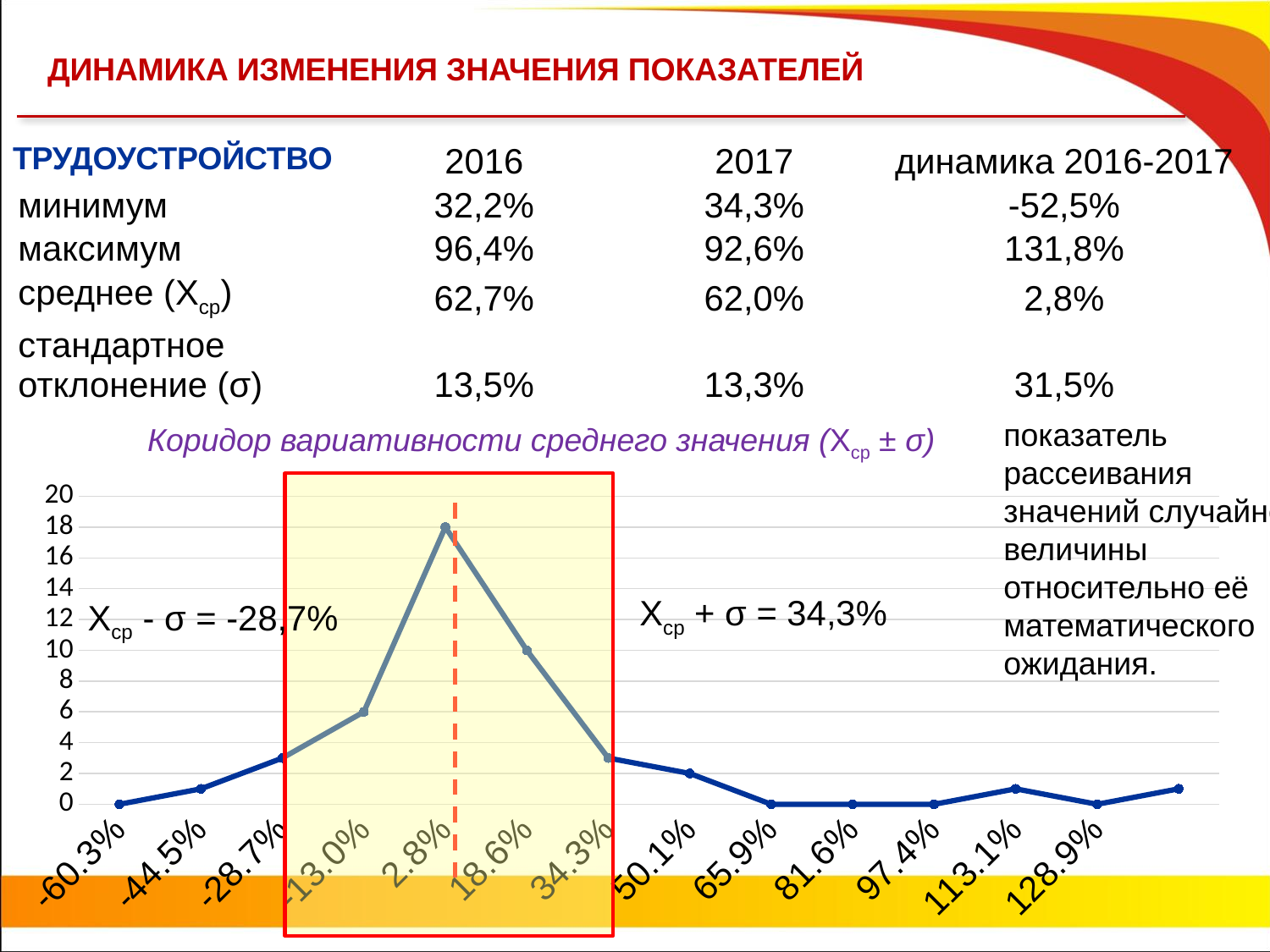
Which category has the highest value on the chart? 2.8% What is the title of the chart? Коридор вариативности среднего значения (Xср ± σ) Is the value for the -28.7% category greater or less than 4? less What is the value plotted at the -13.0% category? 6 Do the values rise or fall along the x axis from 2.8% to 34.3%? fall What is the value plotted at the 2.8% category? 18 What is the value plotted at the 18.6% category? 10 Which has the larger value, the 2.8% category or the 18.6% category? 2.8% What is the difference between the values at 2.8% and 18.6%? 8 What is the value plotted at the 50.1% category? 2 At which x-axis category is the vertical dashed line drawn? 2.8% What kind of chart is shown on the slide? line chart